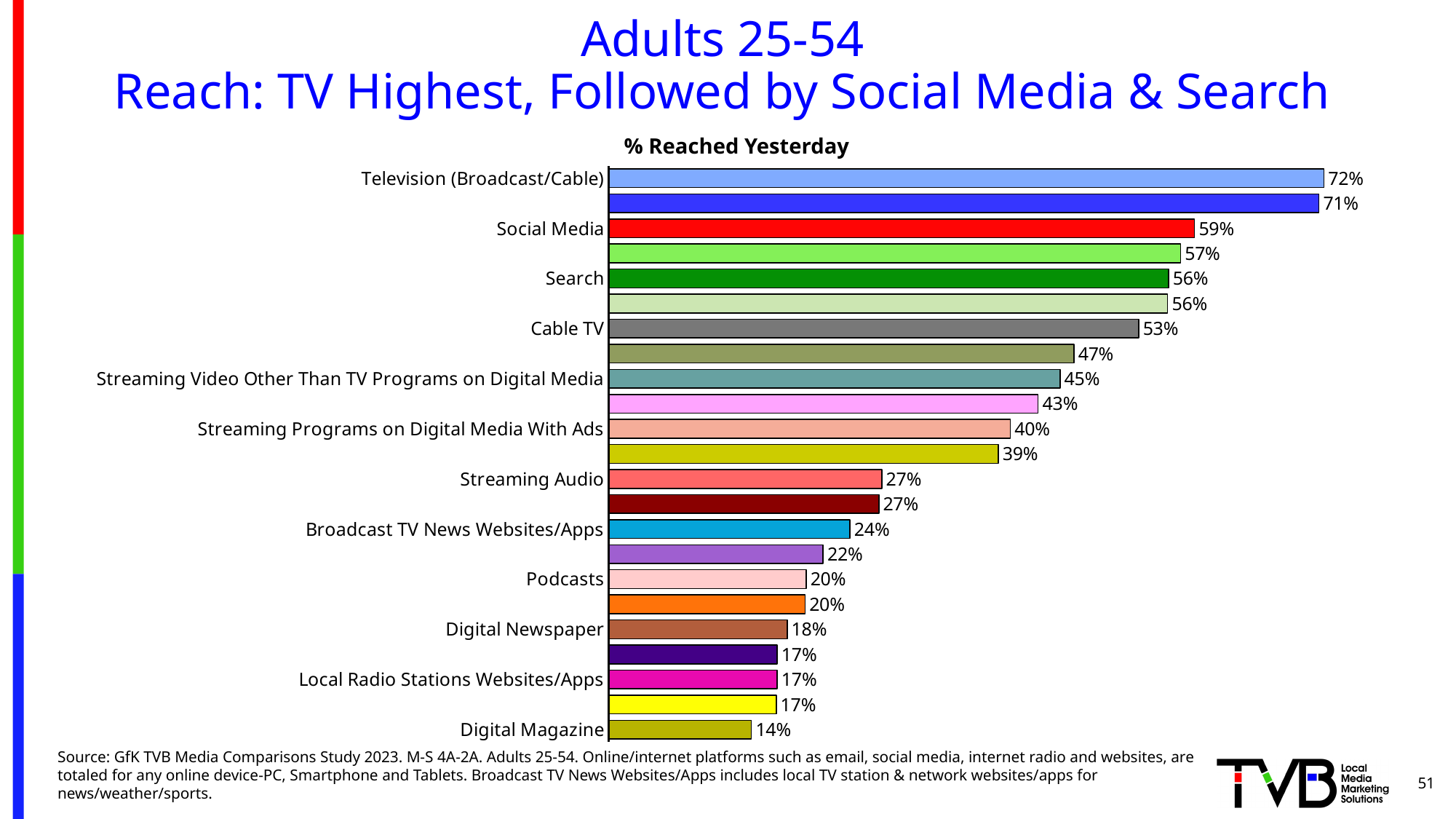
What is the % Reached Yesterday value for Television (Broadcast/Cable)? 72% What is the % Reached Yesterday value for Podcasts? 20% Which has a higher % Reached Yesterday, Search or Streaming Audio? Search What is the % Reached Yesterday value for Cable TV? 53% How many bars are plotted in the chart? 23 What is the difference in % Reached Yesterday between Television (Broadcast/Cable) and Social Media? 13% Which category has the lowest % Reached Yesterday? Digital Magazine What type of chart is shown on the slide? Bar chart What is the % Reached Yesterday value for Digital Magazine? 14% What is the difference in % Reached Yesterday between Streaming Programs on Digital Media With Ads and Broadcast TV News Websites/Apps? 16% Which category has the highest % Reached Yesterday? Television (Broadcast/Cable) What is the % Reached Yesterday value for Social Media? 59%